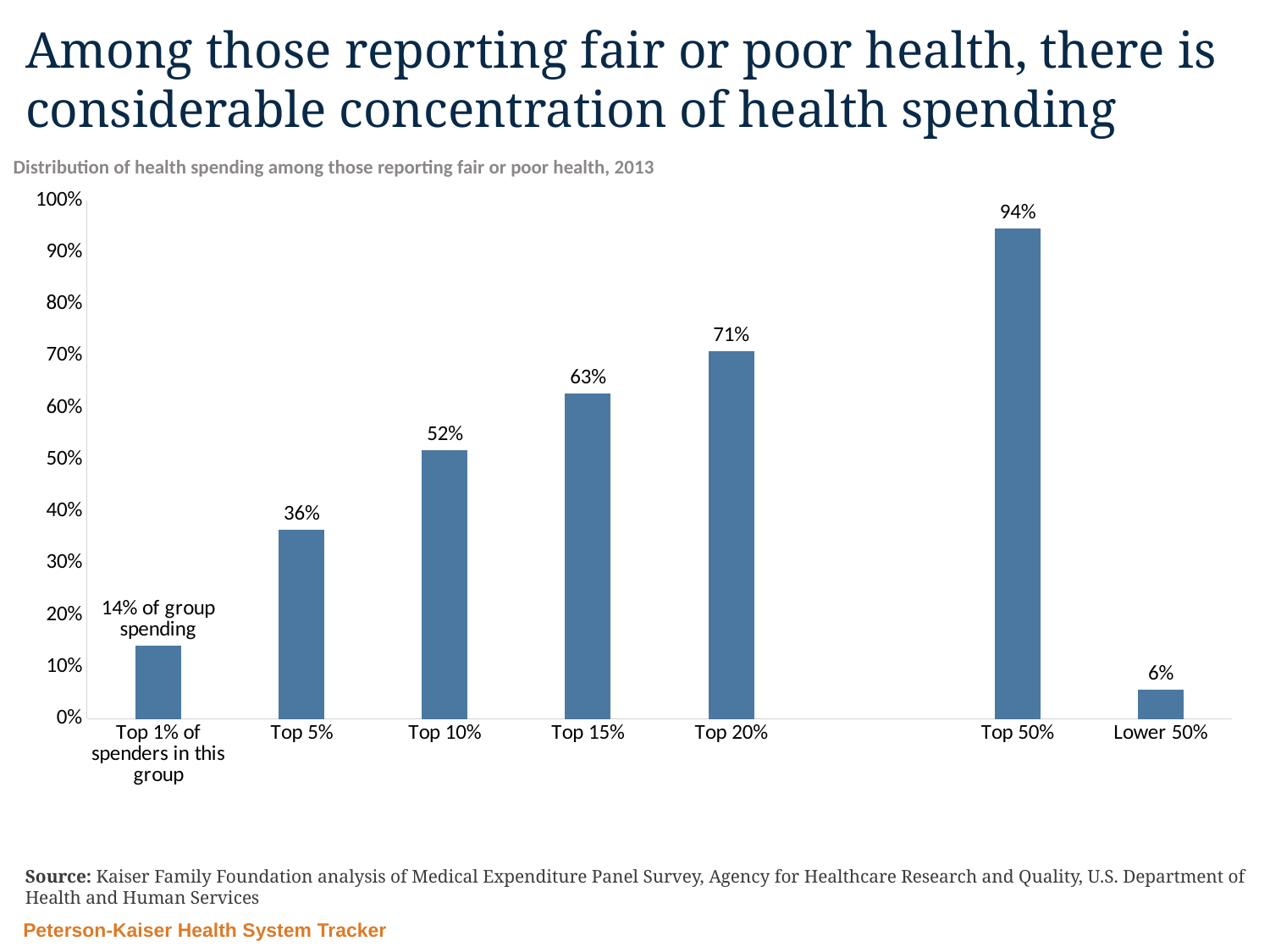
How many categories are shown on the x axis? 7 Which is larger, the value for the Top 10% or the value for the Top 5%? Top 10% What is the difference between the values for the Top 15% and the Top 10%? 11% Which category has the highest share of health spending? Top 50% Which category has the lowest share of health spending? Lower 50% What year does the chart subtitle say the data is from? 2013 Is the value for the Top 15% greater or less than 60%? greater What share of spending is attributed to the Top 1% of spenders in this group? 14% What share of group spending is attributed to the Top 5% of spenders? 36% What kind of chart is shown on the slide? Bar chart What is the difference between the values for the Top 50% and the Lower 50%? 88% What is the value shown for the Top 20% of spenders? 71%